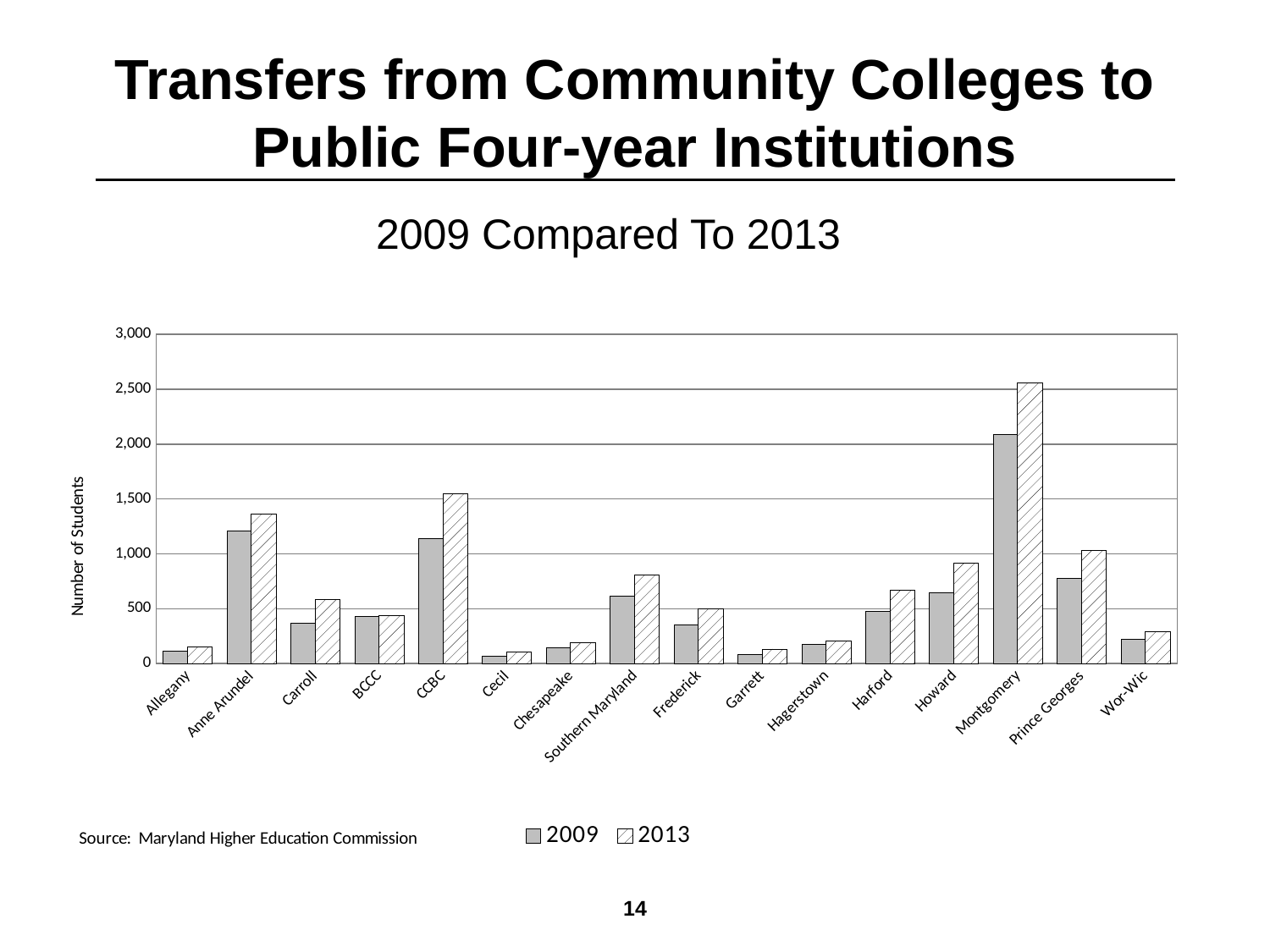
Which community college has the highest number of transfers in 2009? Montgomery Is the 2013 value for CCBC greater or less than 1,000? greater How many series does the legend list? 2 Is the 2009 value for Frederick greater or less than 500? less Which is larger in 2013, the value for Anne Arundel or the value for CCBC? CCBC Is the 2013 value for Montgomery greater or less than 2,000? greater What kind of chart is shown on the slide? bar chart How many community colleges are shown along the x axis? 16 Which community college has the highest number of transfers in 2013? Montgomery Which is larger in 2013, the value for Harford or the value for Southern Maryland? Southern Maryland What is the label of the y axis? Number of Students